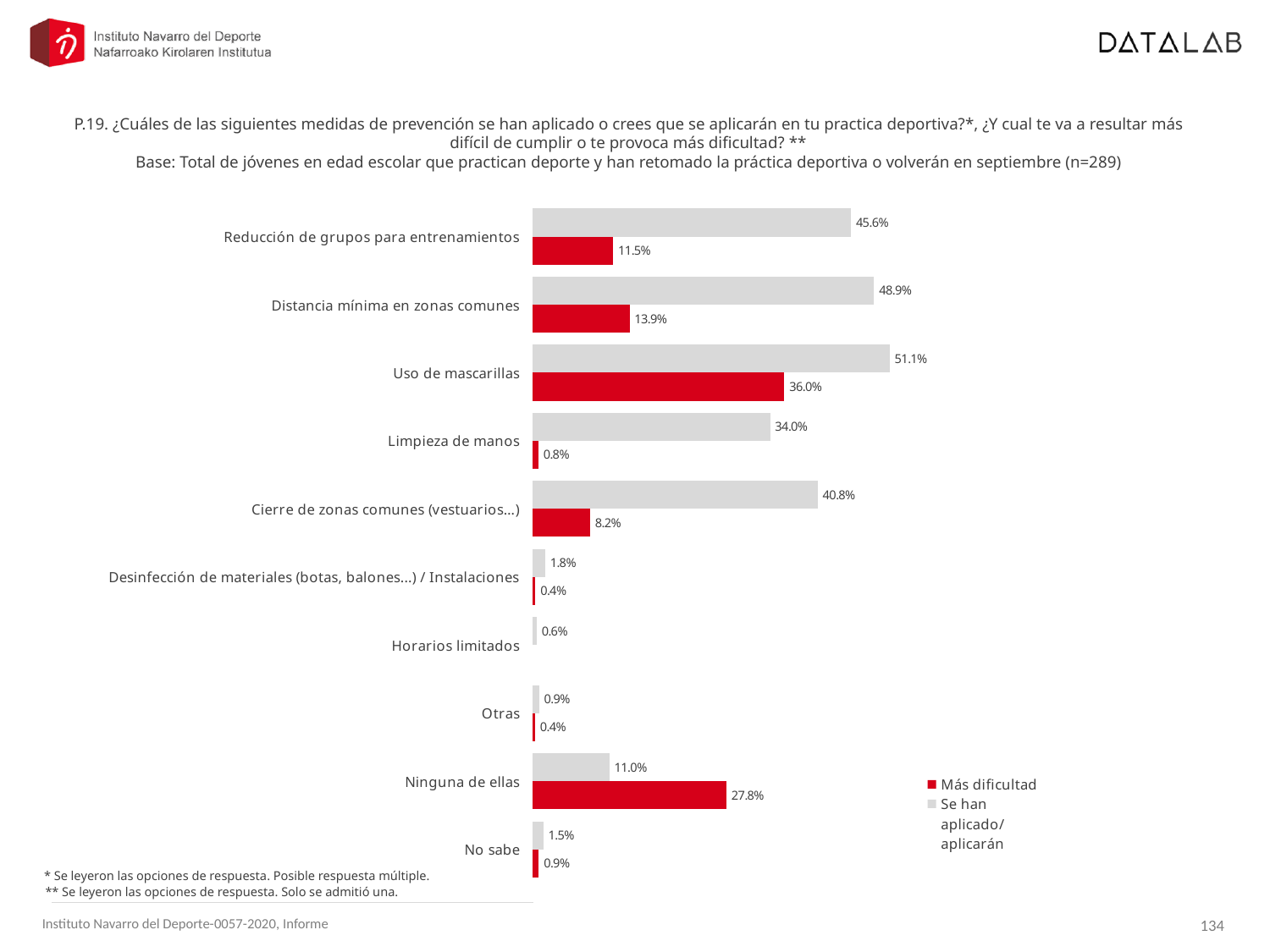
What type of chart is shown on the slide? Bar chart Which measure has the highest 'Más dificultad' value? Uso de mascarillas How many categories are shown on the chart? 10 What percentage of respondents said 'Uso de mascarillas' has been applied or will be applied (Se han aplicado/aplicarán)? 51.1% For 'Ninguna de ellas', which is larger: the 'Más dificultad' value or the 'Se han aplicado/aplicarán' value? Más dificultad Which category has the lowest 'Se han aplicado/aplicarán' value? Horarios limitados What is the difference between the 'Se han aplicado/aplicarán' and 'Más dificultad' values for 'Distancia mínima en zonas comunes'? 35.0% What is the 'Se han aplicado/aplicarán' value for 'Cierre de zonas comunes (vestuarios...)'? 40.8% What is the 'Más dificultad' value for 'Limpieza de manos'? 0.8% What is the 'Más dificultad' value for 'Ninguna de ellas'? 27.8% How many series does the legend list? 2 Which measure has the highest 'Se han aplicado/aplicarán' value? Uso de mascarillas